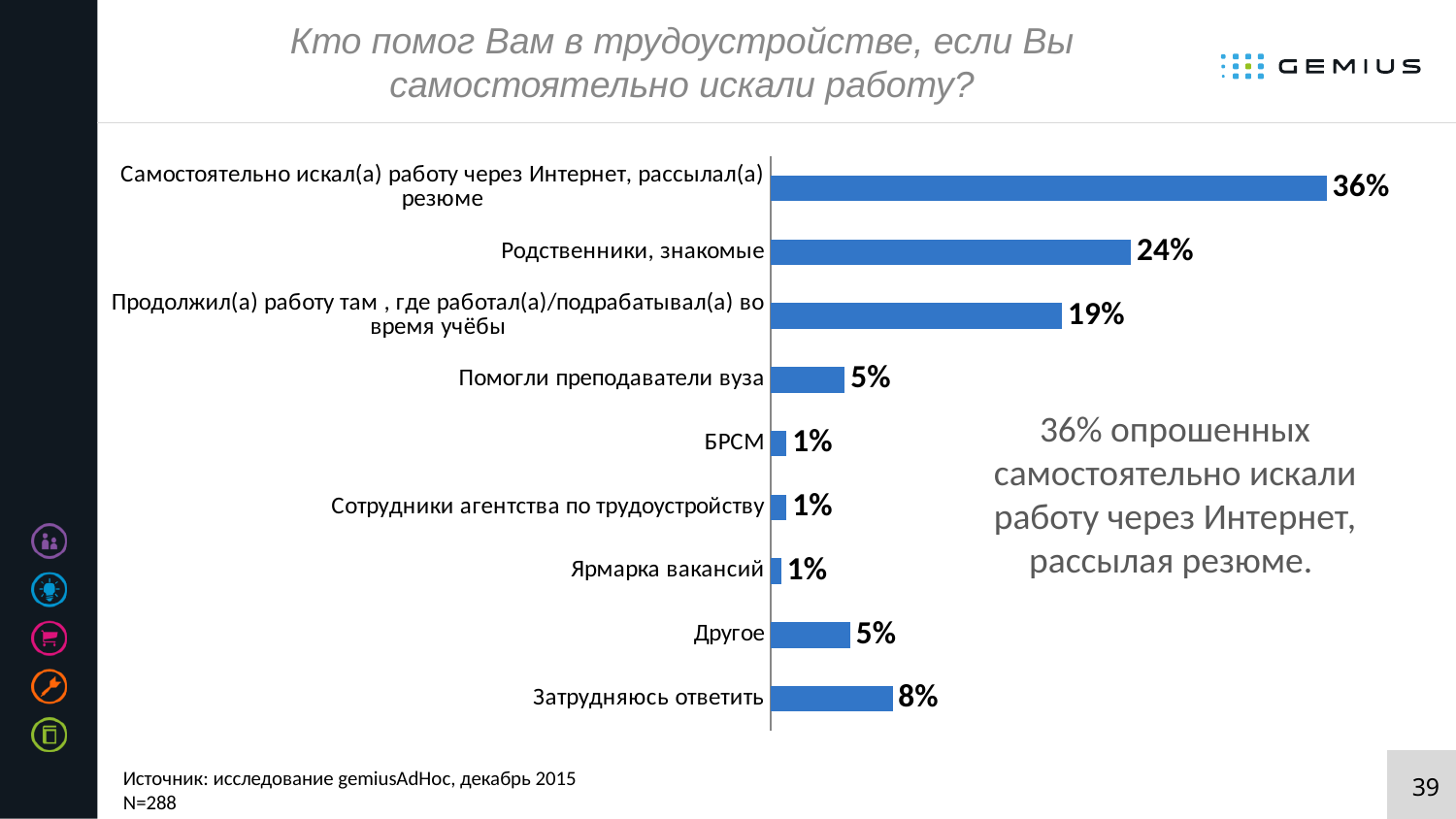
What value is shown for "Помогли преподаватели вуза"? 5% What is the difference between the values for "Самостоятельно искал(а) работу через Интернет, рассылал(а) резюме" and "Родственники, знакомые"? 12% What kind of chart is shown on the slide? Bar chart How many categories are shown in the chart? 9 What value is shown for "Затрудняюсь ответить"? 8% What is the difference between the values for "Затрудняюсь ответить" and "Другое"? 3% Which is larger, the value for "Родственники, знакомые" or the value for "Продолжил(а) работу там, где работал(а)/подрабатывал(а) во время учёбы"? Родственники, знакомые What is the sample size (N) stated on the slide? 288 What value is shown for "Родственники, знакомые"? 24% Which category has the highest value? Самостоятельно искал(а) работу через Интернет, рассылал(а) резюме What value is shown for "БРСМ"? 1% What value is shown for "Продолжил(а) работу там, где работал(а)/подрабатывал(а) во время учёбы"? 19%